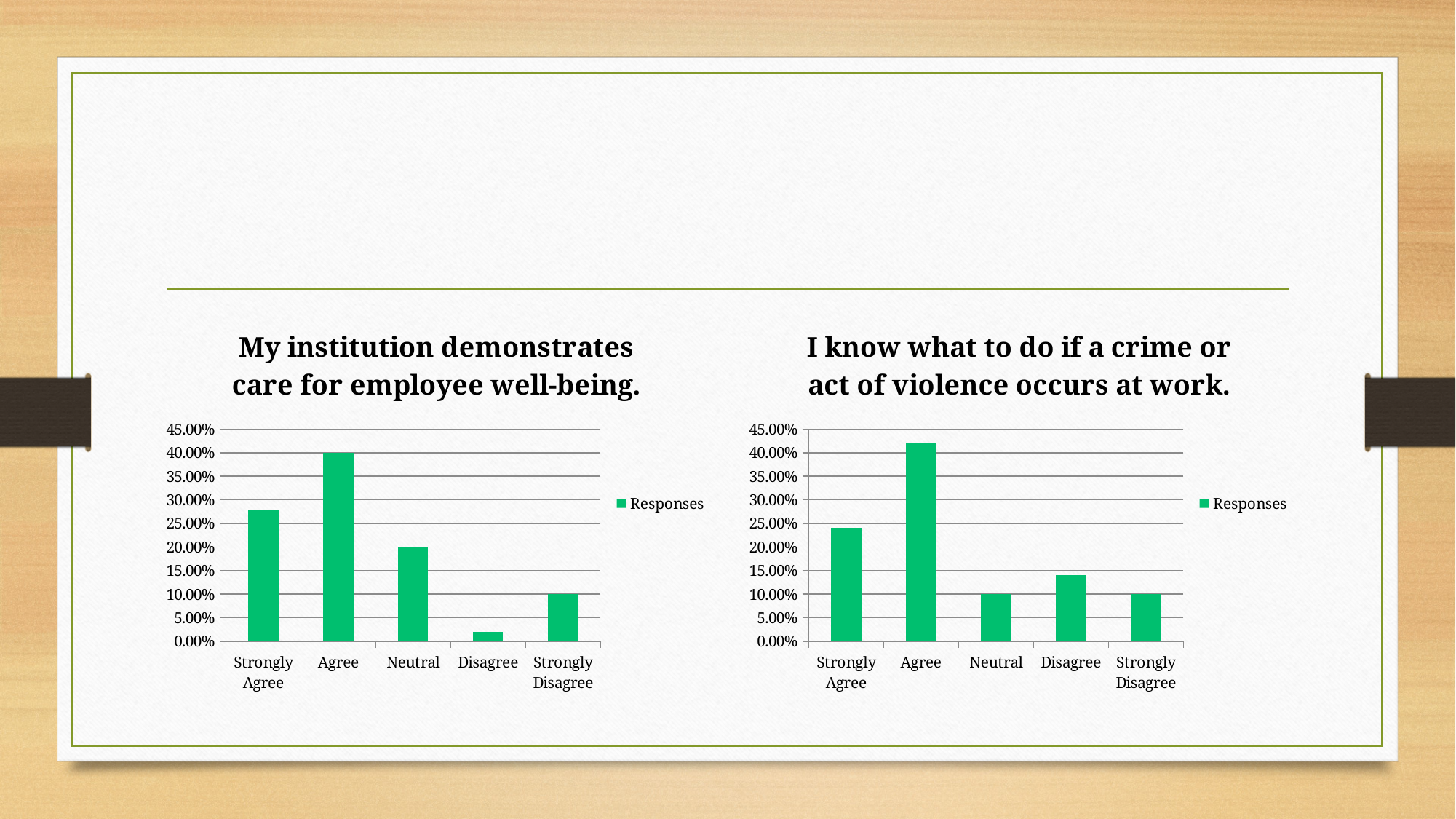
What kind of chart is the chart titled "My institution demonstrates care for employee well-being."? bar chart In the chart titled "My institution demonstrates care for employee well-being.", which category has the lowest value? Disagree In the chart titled "My institution demonstrates care for employee well-being.", is the value for Strongly Agree greater or less than 25.00%? greater In the chart titled "I know what to do if a crime or act of violence occurs at work.", what is the value for Neutral? 10.00% In the chart titled "My institution demonstrates care for employee well-being.", what is the value for Agree? 40.00% In the chart titled "My institution demonstrates care for employee well-being.", which category has the highest value? Agree How many categories are shown on the x axis of the chart titled "I know what to do if a crime or act of violence occurs at work."? 5 In the chart titled "I know what to do if a crime or act of violence occurs at work.", which is larger, the value for Strongly Agree or the value for Disagree? Strongly Agree In the chart titled "I know what to do if a crime or act of violence occurs at work.", which category has the highest value? Agree In the chart titled "My institution demonstrates care for employee well-being.", what is the difference between the values for Agree and Neutral? 20.00% In the chart titled "My institution demonstrates care for employee well-being.", what is the value for Neutral? 20.00%